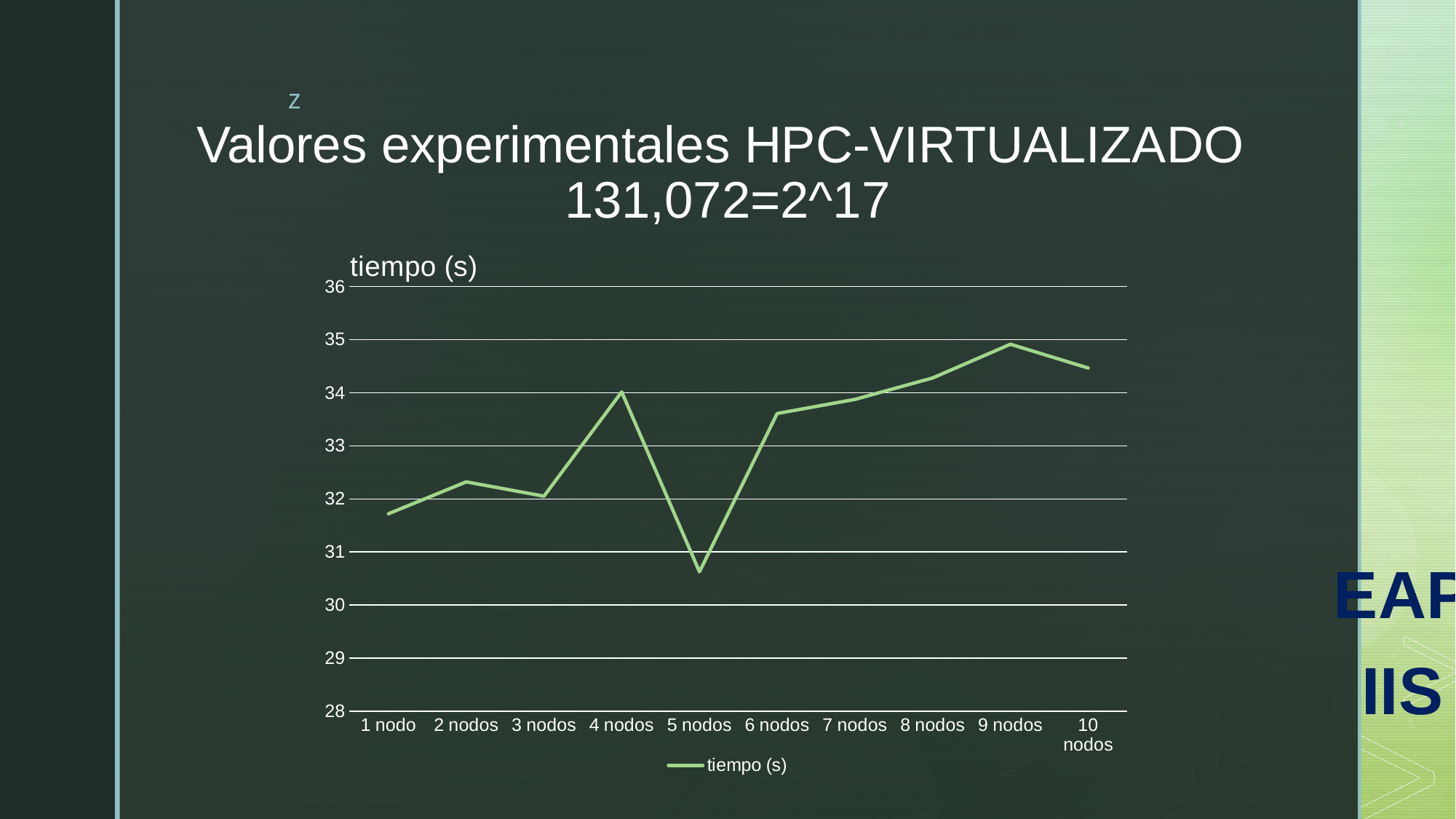
Which category has the highest tiempo (s) value? 9 nodos Is the value for 5 nodos greater or less than 31? less Is the value for 6 nodos greater or less than 33? greater How many categories (node counts) are plotted along the x axis? 10 What kind of chart is shown on the slide? line chart Which is larger, the value for 4 nodos or the value for 5 nodos? 4 nodos What is the title shown above the chart's plot area? tiempo (s) Is the value for 9 nodos greater or less than 34? greater How many series does the legend list? 1 Which category has the lowest tiempo (s) value? 5 nodos Do the values rise or fall from 6 nodos to 9 nodos? rise